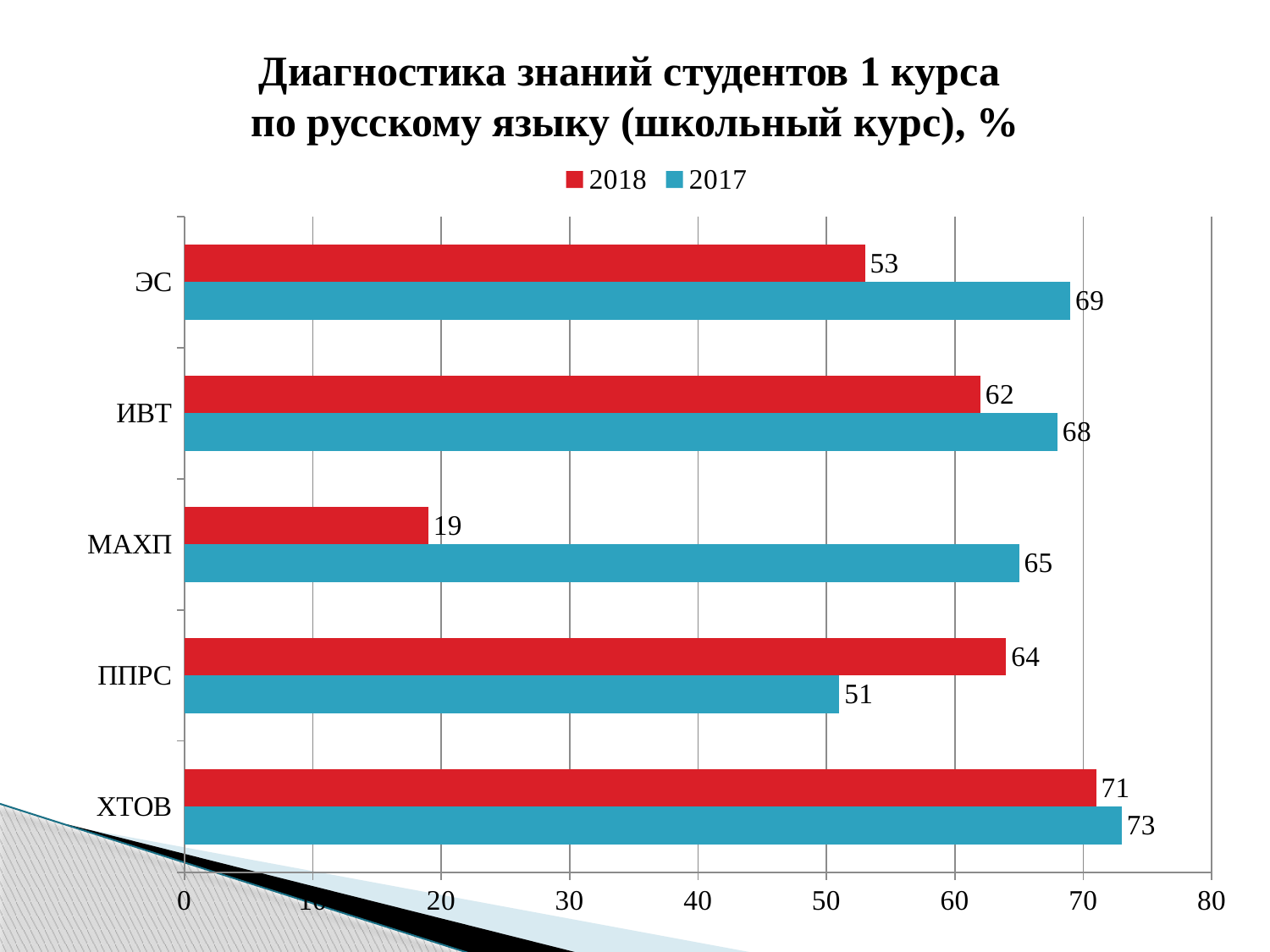
Which category has the lowest 2018 value? МАХП How many series does the legend list? 2 Which category has the highest 2017 value? ХТОВ What is the difference between the 2017 and 2018 values for МАХП? 46 Which is larger for ИВТ, the 2018 value or the 2017 value? 2017 What kind of chart is shown on the slide? bar chart What is the 2018 value for МАХП? 19 What is the 2017 value for ЭС? 69 Which colour represents the 2018 series? red What is the difference between the 2018 and 2017 values for ППРС? 13 What is the 2018 value for ХТОВ? 71 How many categories are shown on the chart? 5